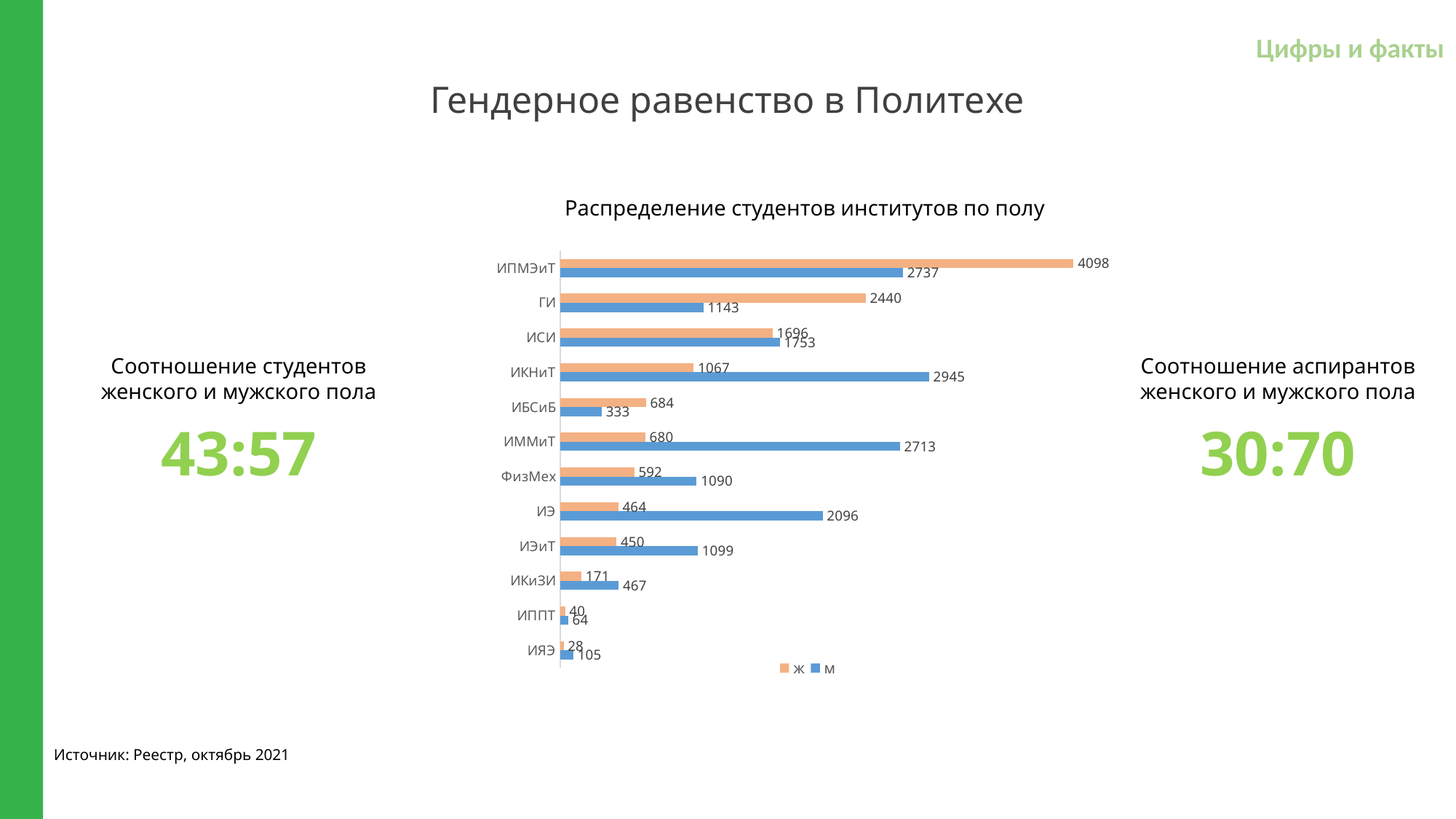
Which institute has the lowest ж (female) value? ИЯЭ At ИММиТ, which is larger: the ж value or the м value? м Which institute has the highest м (male) value? ИКНиТ What is the value for ж at ИБСиБ? 684 What kind of chart is shown on the slide? bar chart How many series does the legend list? 2 What is the title of the chart? Распределение студентов институтов по полу What is the total of the ж and м values at ИППТ? 104 What is the value for м (male) at ИКНиТ? 2945 What is the difference between the ж and м values at ГИ? 1297 How many institutes are shown on the chart? 12 What is the value for ж (female) at ИПМЭиТ? 4098